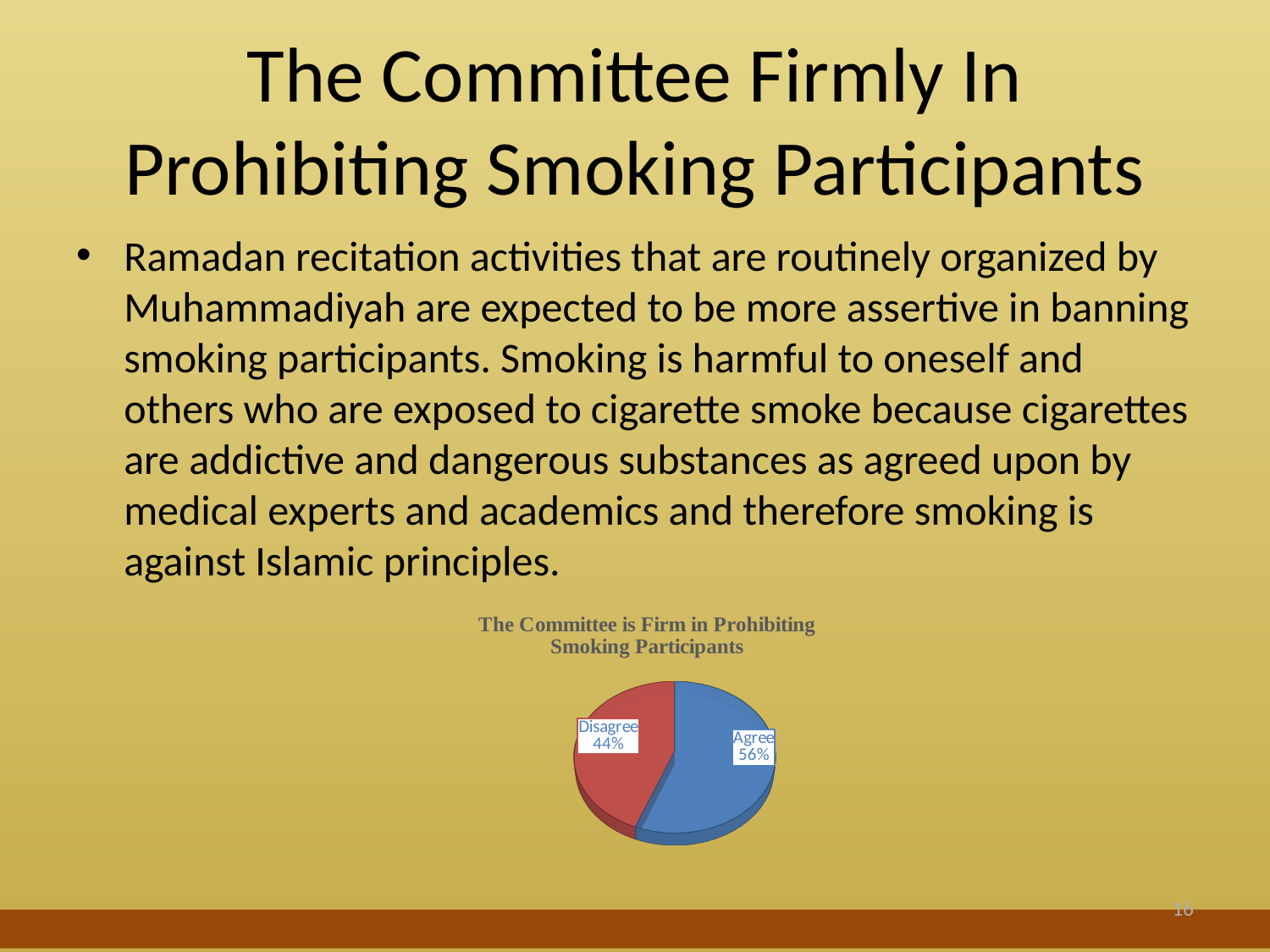
What colour is the Disagree slice of the pie? Red What share of the pie does the Disagree slice represent? 44% How many slices does the pie chart have? 2 What is the difference in percentage points between the Agree and Disagree slices? 12% What share of the pie does the Agree slice represent? 56% Which slice of the pie is the largest? Agree Which slice of the pie is the smallest? Disagree What is the title of the chart? The Committee is Firm in Prohibiting Smoking Participants Which is larger, the Agree slice or the Disagree slice? Agree What kind of chart is shown on the slide? Pie chart